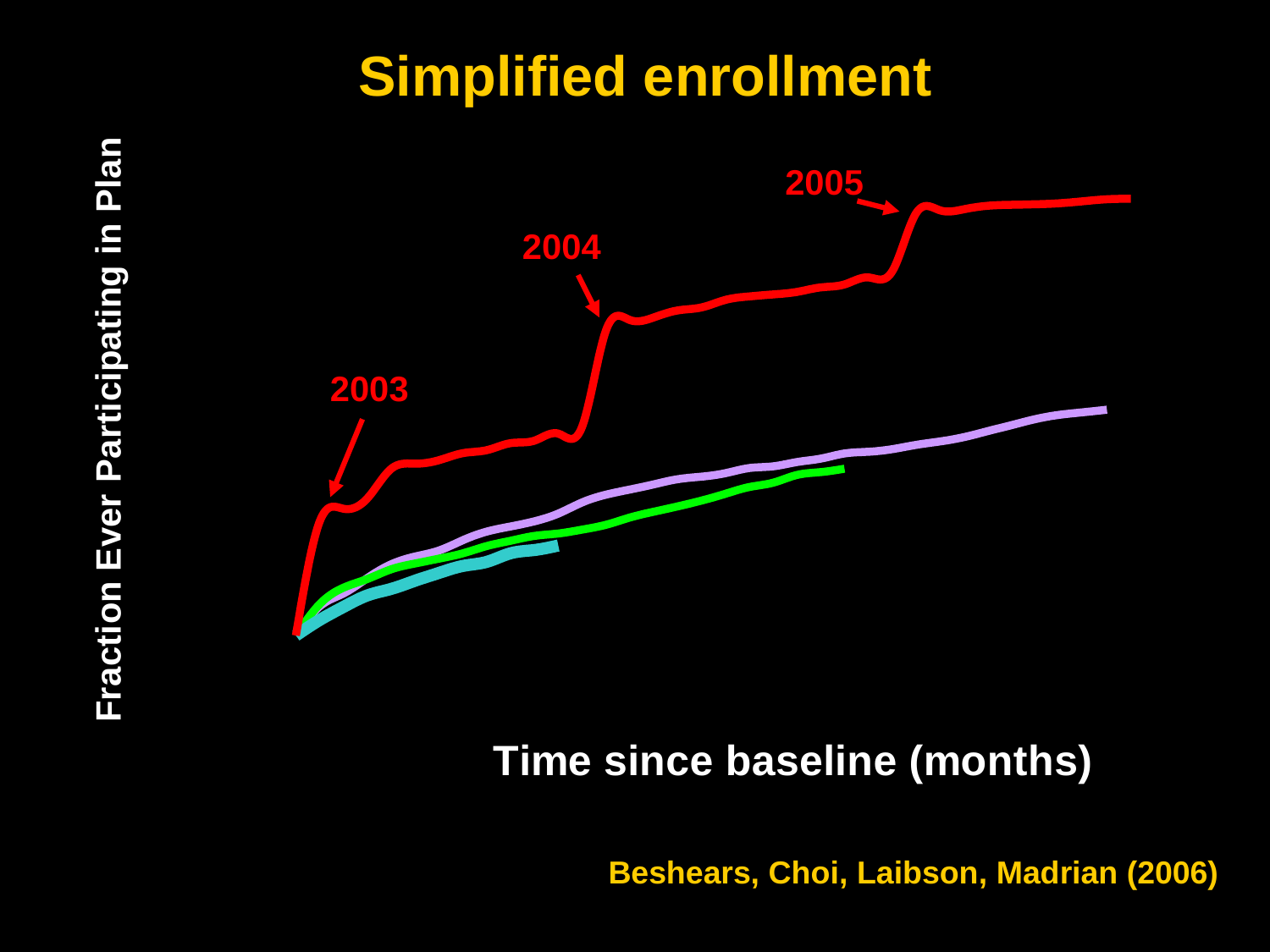
Which years are marked with arrows along the red line? 2003, 2004, 2005 Which line ends higher on the right side of the chart, the red line or the purple line? The red line Which line reaches the highest fraction ever participating in the plan? The red line Which line extends furthest to the right along the time axis? The red line What is the label on the vertical axis of the chart? Fraction Ever Participating in Plan How many lines are plotted on the chart? 4 Which line is higher where they overlap, the purple line or the green line? The purple line Does the purple line rise or fall over time since baseline? Rises Does the red line rise or fall as time since baseline increases? Rises Which line stays lowest on the chart? The cyan line What is the title of the chart? Simplified enrollment What kind of chart is shown on the slide? Line chart